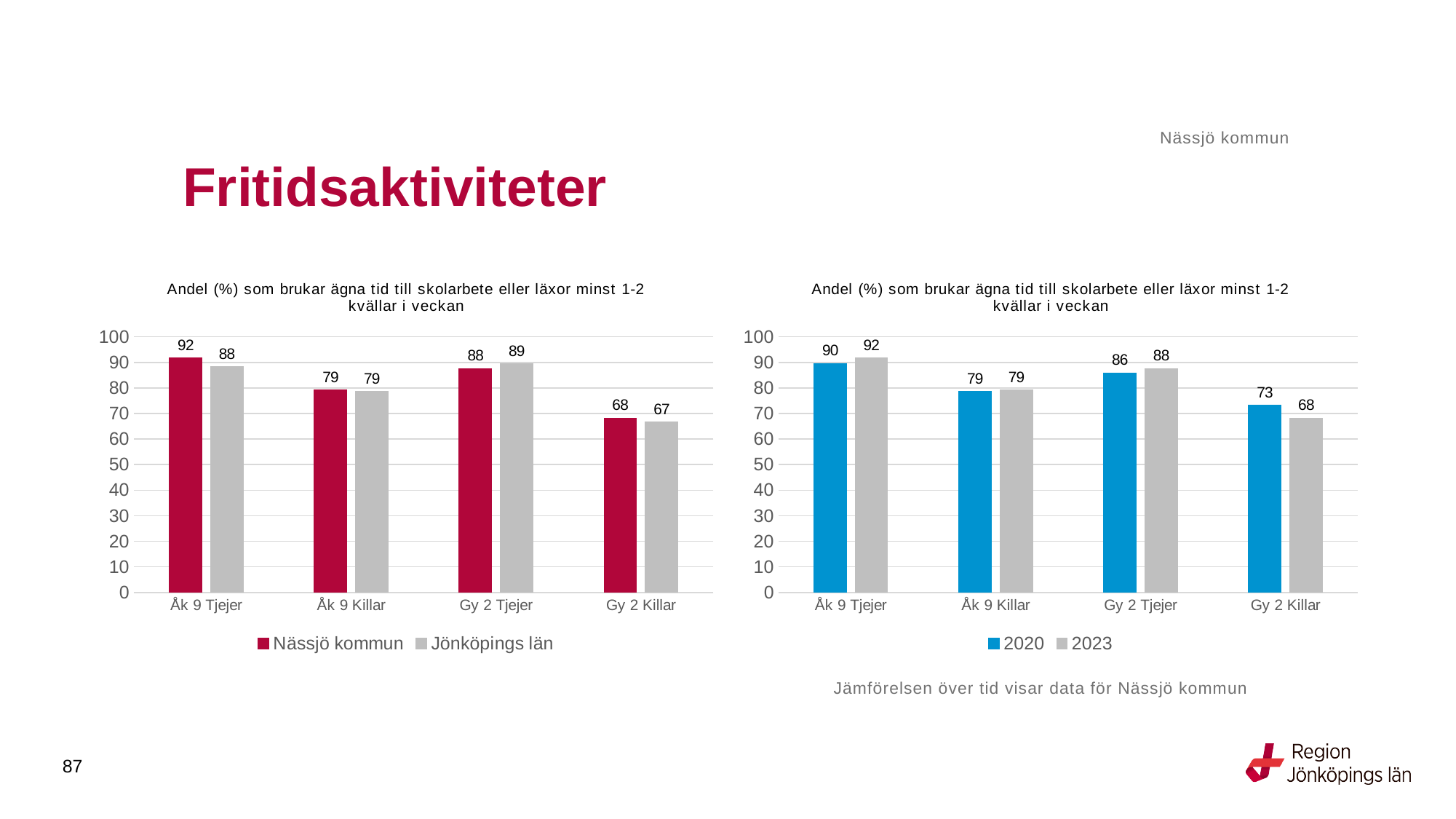
In the left chart, which category has the lowest value for Nässjö kommun? Gy 2 Killar What kind of chart is the right chart? Bar chart In the right chart, how many categories are shown on the x axis? 4 In the left chart, which is larger for Gy 2 Tjejer: Nässjö kommun or Jönköpings län? Jönköpings län In the right chart, what is the difference between 2020 and 2023 for Gy 2 Killar? 5 In the left chart, what is the value for Nässjö kommun for Åk 9 Tjejer? 92 In the left chart, what is the difference between Nässjö kommun and Jönköpings län for Åk 9 Tjejer? 4 In the right chart, what is the value for 2020 for Gy 2 Tjejer? 86 In the left chart, how many series does the legend list? 2 In the right chart, what is the value for 2023 for Gy 2 Killar? 68 In the left chart, what is the value for Jönköpings län for Gy 2 Killar? 67 In the right chart, which category has the highest value for 2023? Åk 9 Tjejer